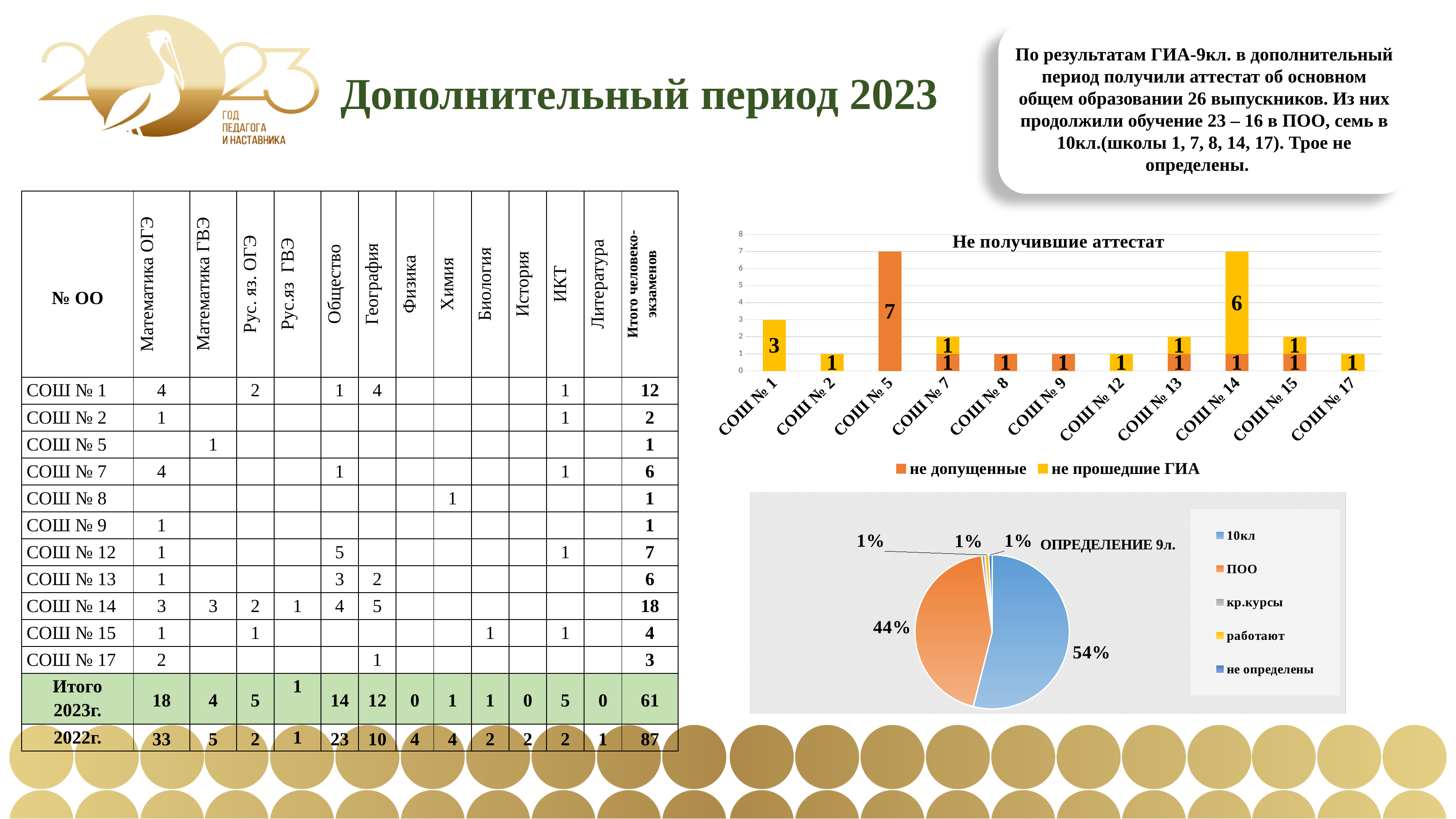
In the pie chart titled "ОПРЕДЕЛЕНИЕ 9л.", which category has the largest share? 10кл In the chart titled "Не получившие аттестат", how many schools are shown on the x axis? 11 In the chart titled "Не получившие аттестат", what is the total of the stacked bar for СОШ № 7? 2 In the chart titled "Не получившие аттестат", what is the difference between the "не прошедшие ГИА" value for СОШ № 14 and for СОШ № 1? 3 In the chart titled "Не получившие аттестат", what is the value of "не допущенные" for СОШ № 5? 7 In the chart titled "Не получившие аттестат", what is the total of the stacked bar for СОШ № 14? 7 In the chart titled "Не получившие аттестат", what is the value of "не прошедшие ГИА" for СОШ № 14? 6 In the pie chart titled "ОПРЕДЕЛЕНИЕ 9л.", how many categories does the legend list? 5 In the chart titled "Не получившие аттестат", how many series does the legend list? 2 In the pie chart titled "ОПРЕДЕЛЕНИЕ 9л.", what share does "10кл" have? 54% In the chart titled "Не получившие аттестат", what is the value of "не прошедшие ГИА" for СОШ № 1? 3 In the chart titled "Не получившие аттестат", which school has the highest value of "не допущенные"? СОШ № 5